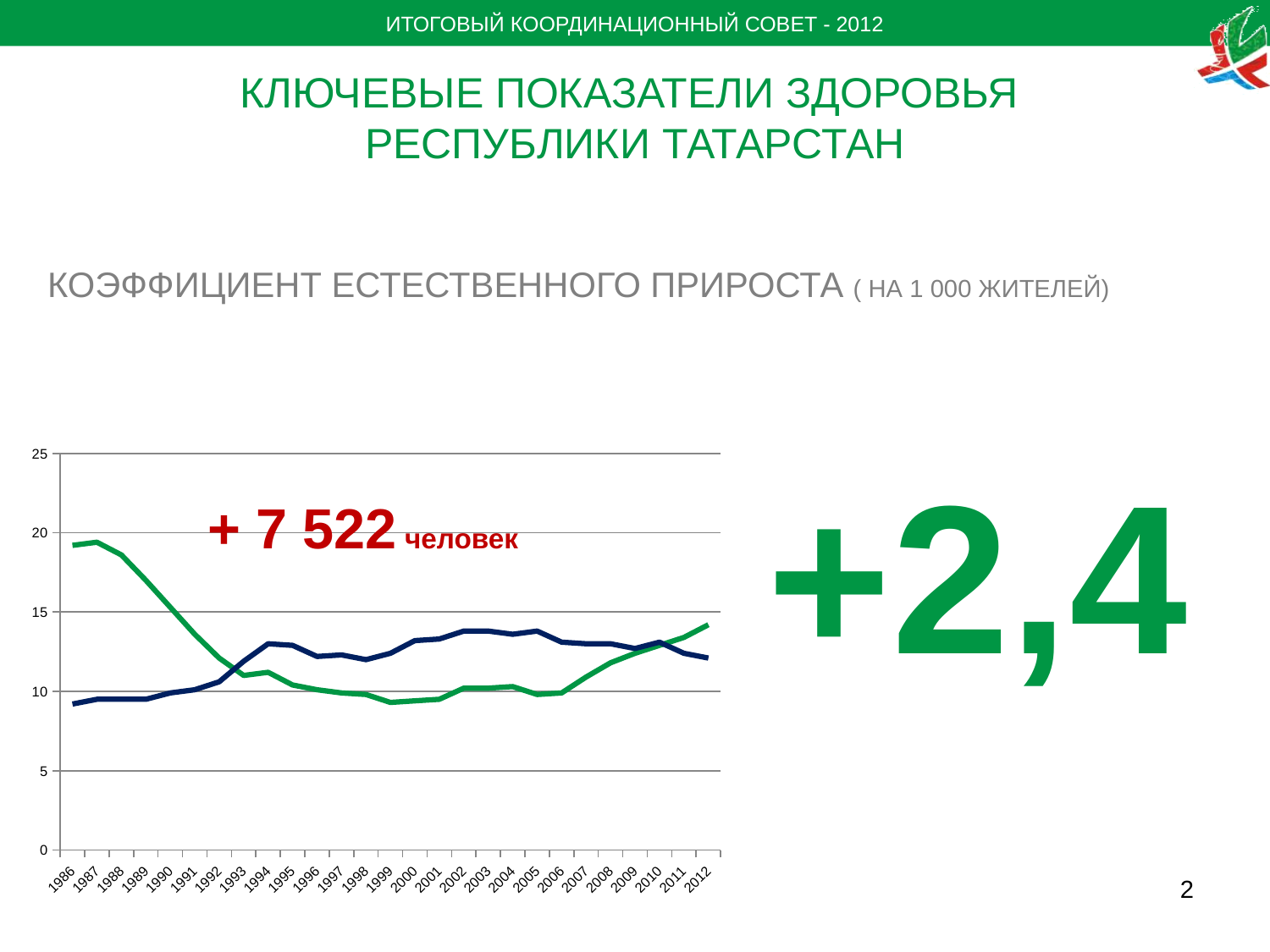
What is the first year shown on the x axis of the chart? 1986 Does the green line rise or fall between 1986 and 1999? fall What kind of chart is shown on the slide? line chart What is the last year shown on the x axis of the chart? 2012 How many years are plotted along the x axis of the chart? 27 Is the value of the green line in 1986 greater or less than 15? greater Is the value of the dark blue line in 2003 greater or less than 10? greater Is the value of the green line in 1999 greater or less than 10? less How many lines are plotted on the chart? 2 What is the highest value shown on the y axis of the chart? 25 In 2000, which line has the higher value, the green line or the dark blue line? the dark blue line